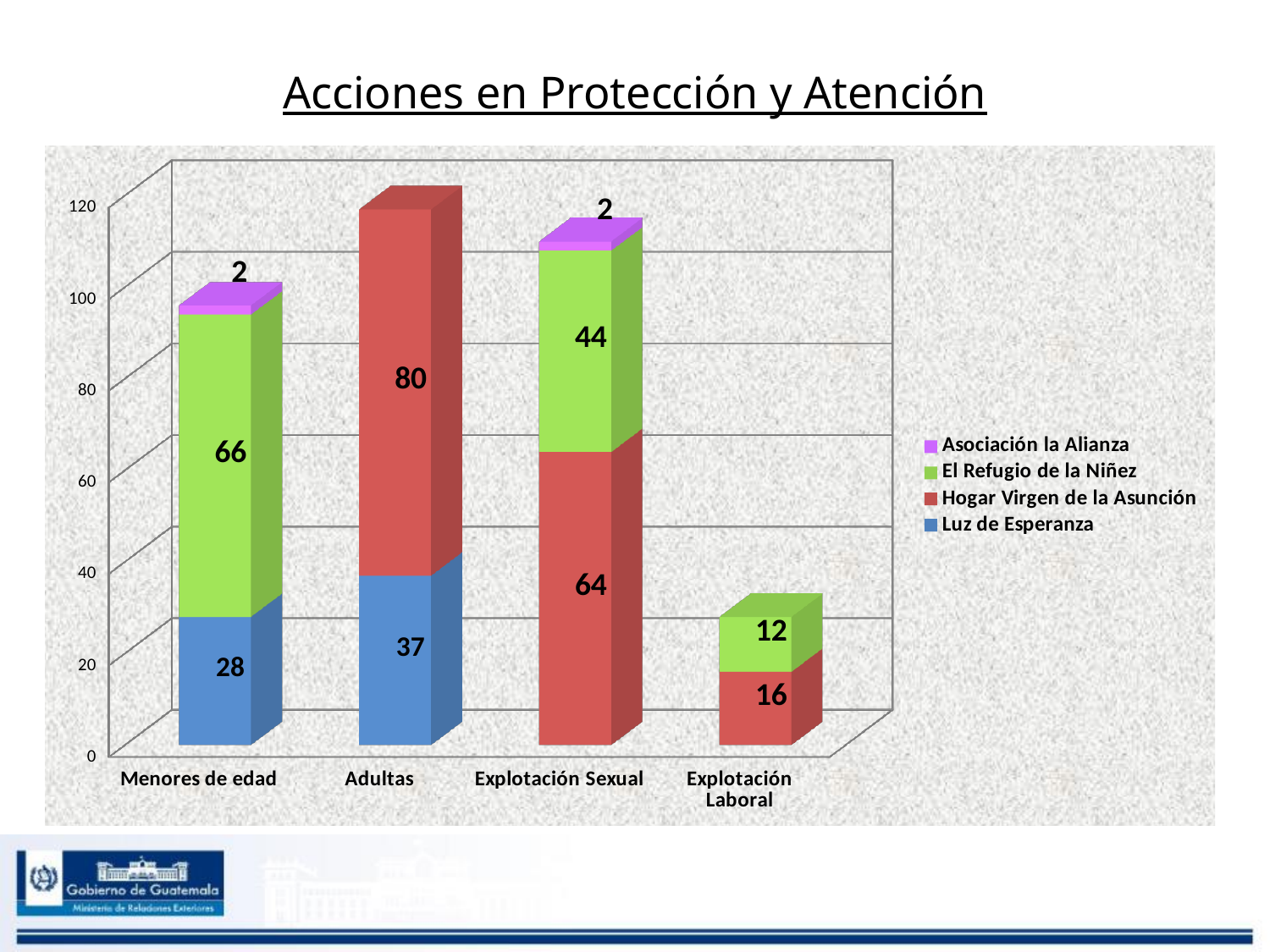
What is the total of the stacked bar for Explotación Laboral? 28 How many series does the legend list? 4 What is the difference between the El Refugio de la Niñez values for Menores de edad and Explotación Sexual? 22 Which is larger: the Luz de Esperanza value for Adultas or for Menores de edad? Adultas What is the value for Hogar Virgen de la Asunción in the Adultas category? 80 What is the value for Luz de Esperanza in the Menores de edad category? 28 What kind of chart is shown on the slide? Stacked bar chart Which category has the tallest stacked bar? Adultas What is the total of the stacked bar for Adultas? 117 What is the value for Hogar Virgen de la Asunción in the Explotación Laboral category? 16 How many categories are shown on the x axis? 4 What is the value for El Refugio de la Niñez in the Explotación Sexual category? 44